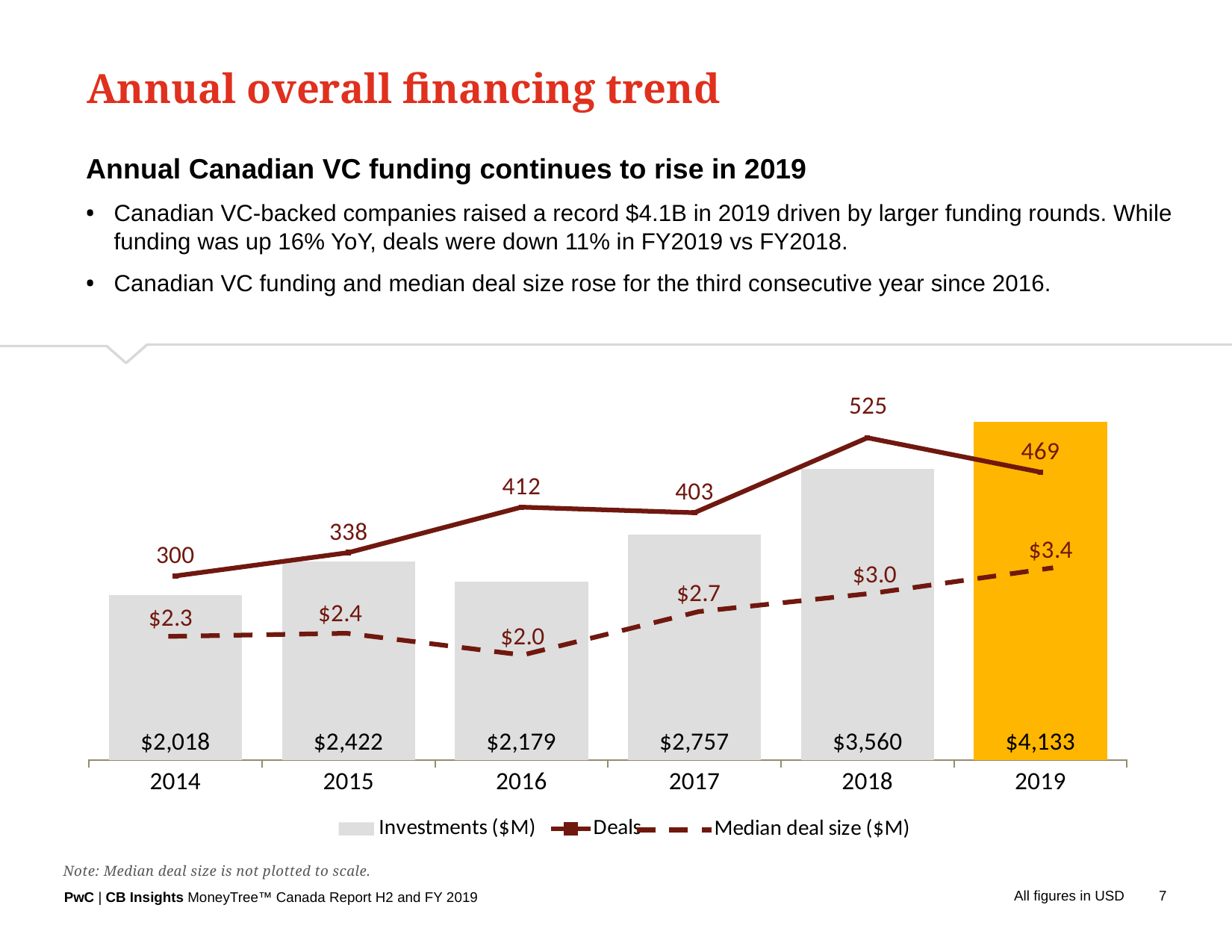
How many years are shown on the x axis? 6 How many series does the legend list? 3 Which year had more Deals, 2016 or 2017? 2016 What is the difference in Deals between 2018 and 2019? 56 Which year has the lowest Median deal size ($M)? 2016 How many Deals were there in 2018? 525 Which year has the highest Investments ($M)? 2019 What is the difference in Investments ($M) between 2019 and 2018? $573 Which year has the lowest number of Deals? 2014 What is the Median deal size ($M) for 2016? $2.0 Does the Median deal size ($M) rise or fall from 2016 to 2019? rise What is the value of Investments ($M) for 2019? $4,133